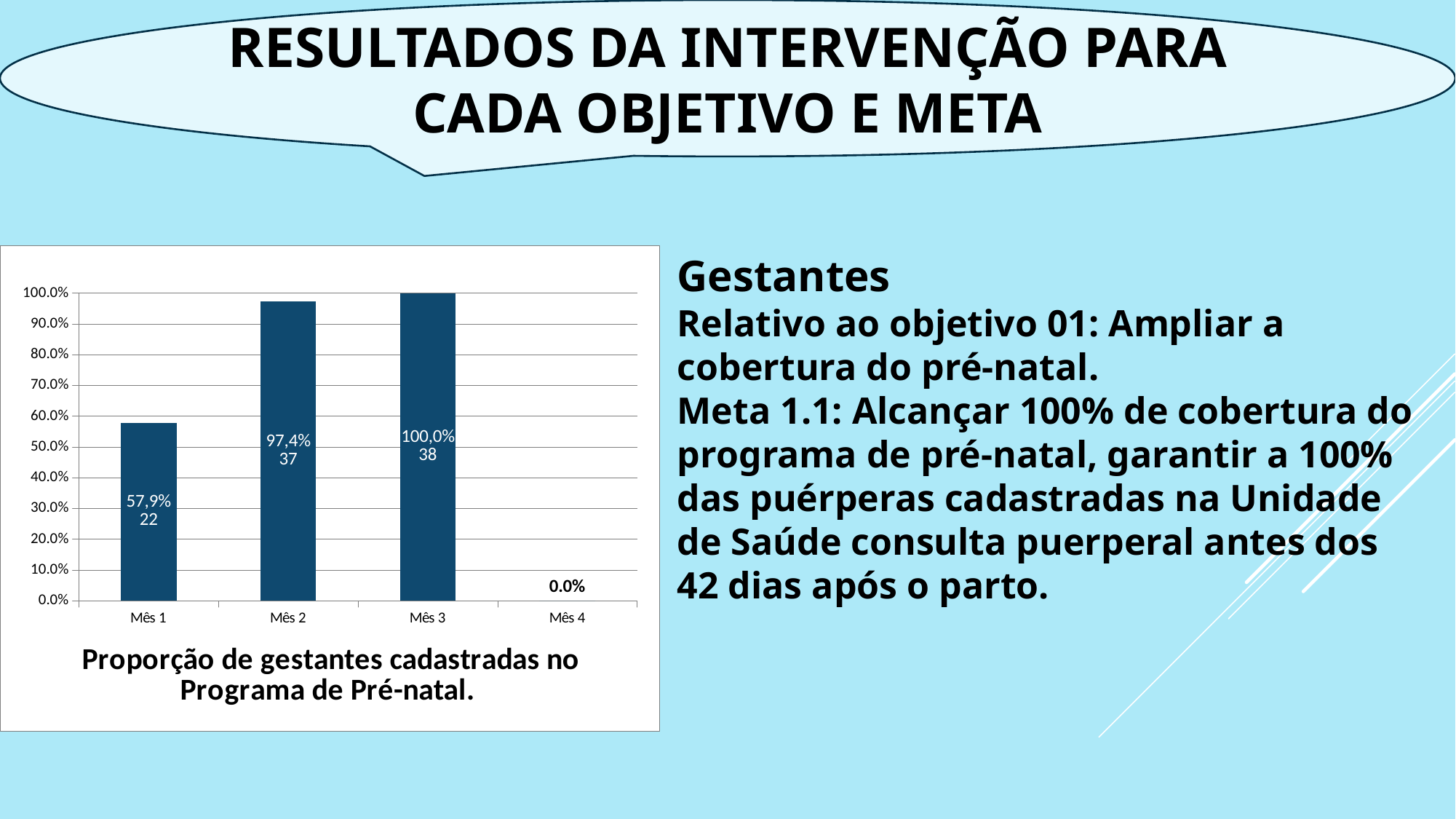
What percentage is shown for Mês 2 in the chart? 97,4% What kind of chart is shown on the slide? Bar chart What value is shown for Mês 4 in the chart? 0.0% Is the value for Mês 1 greater or less than 50.0%? greater Which is larger, the value for Mês 1 or the value for Mês 2? Mês 2 What count is printed on the bar for Mês 3? 38 Which month has the highest proportion in the chart? Mês 3 What percentage is shown for Mês 1 in the chart? 57,9% How many months (categories) are shown on the x axis of the chart? 4 What is the title of the chart on the slide? Proporção de gestantes cadastradas no Programa de Pré-natal. What is the difference between the counts printed for Mês 2 and Mês 1? 15 Which month has the lowest value in the chart? Mês 4